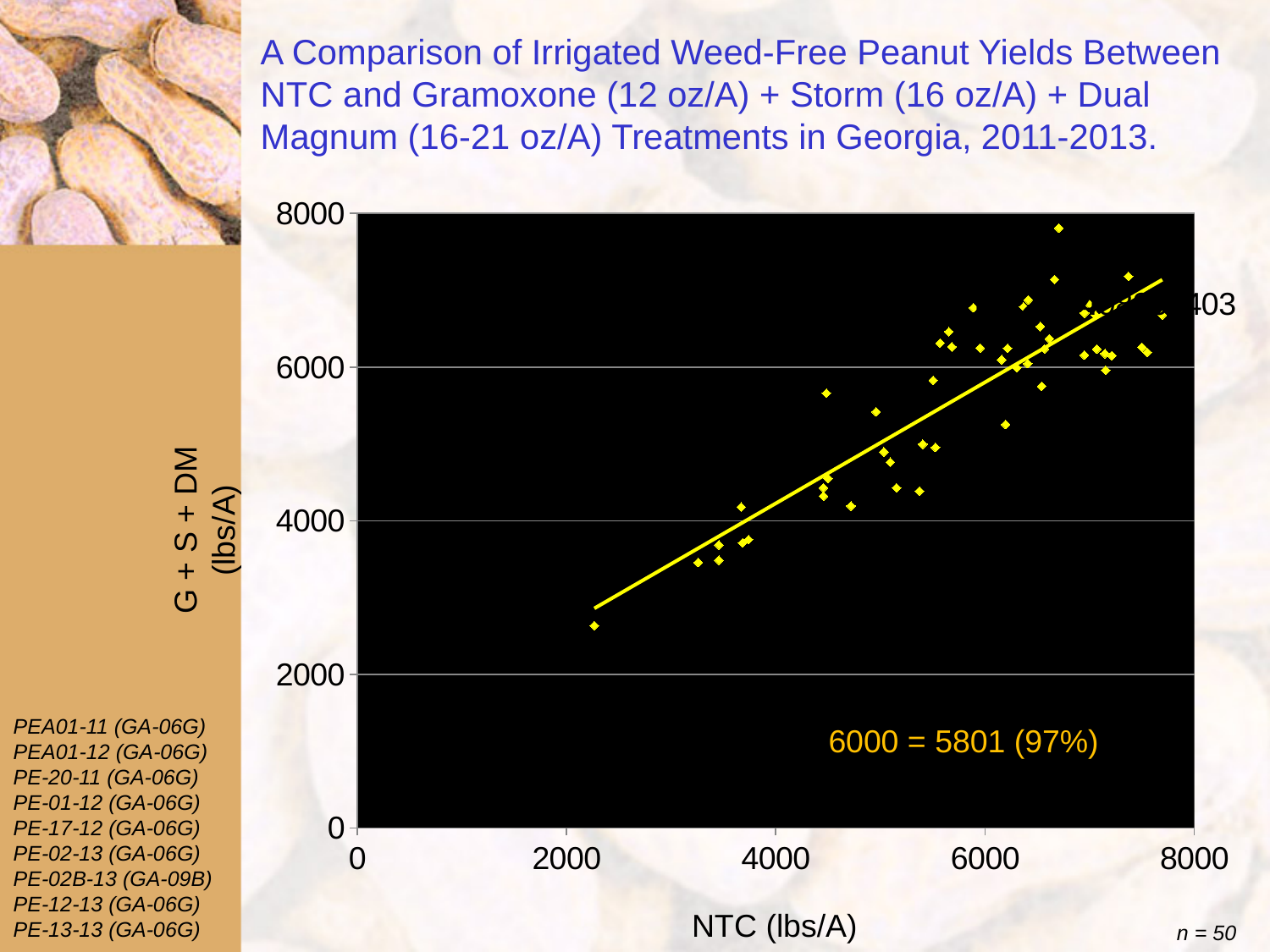
Is the G + S + DM value of the leftmost data point greater or less than 4000? less According to the annotation on the chart, what G + S + DM yield corresponds to an NTC yield of 6000? 5801 What is the highest value shown on the x axis of the chart? 8000 Is the G + S + DM value of the highest data point greater or less than 6000? greater Do the plotted G + S + DM yields rise or fall as NTC yield increases along the x axis? Rise What percentage is given in the annotation '6000 = 5801' on the chart? 97% What is the label of the x axis of the chart? NTC (lbs/A) How many data points (n) does the chart contain, according to the note on the slide? 50 Which years does the chart title say the data covers? 2011-2013 What kind of chart is shown on the slide? Scatter chart What is the label of the y axis of the chart? G + S + DM (lbs/A)